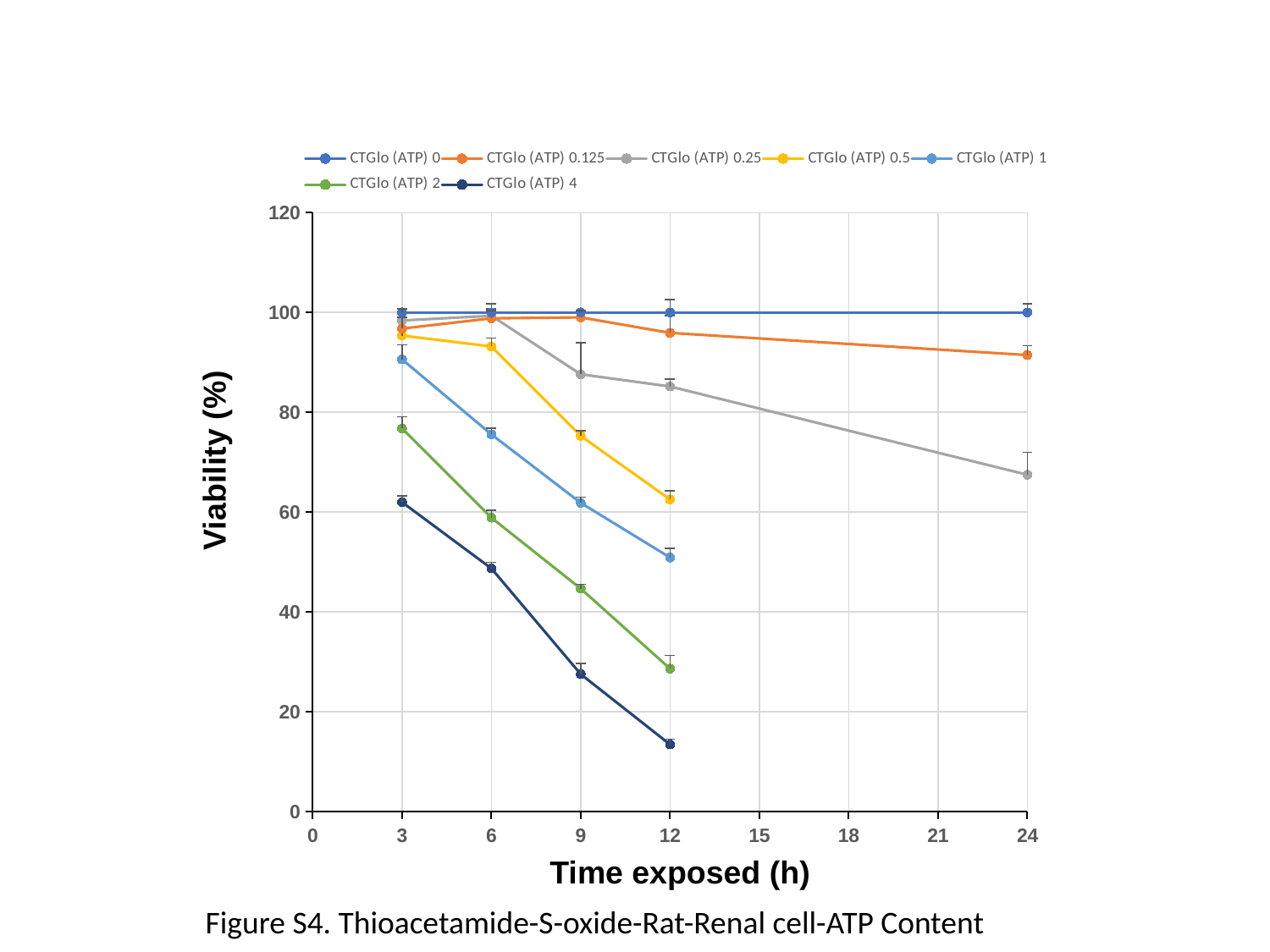
Is the value for CTGlo (ATP) 4 at 12 h greater or less than 20? less What is the title of the x axis? Time exposed (h) Which series has the highest viability at 24 h? CTGlo (ATP) 0 What kind of chart is shown on the slide? line chart Which series has the lowest viability at 12 h? CTGlo (ATP) 4 Is the value for CTGlo (ATP) 1 at 12 h greater or less than 60? less Is the value for CTGlo (ATP) 2 at 3 h greater or less than 80? less Which is larger at 9 h, the value for CTGlo (ATP) 0.5 or the value for CTGlo (ATP) 2? CTGlo (ATP) 0.5 What is the title of the y axis? Viability (%) Do the values for CTGlo (ATP) 4 rise or fall as time exposed increases? fall How many series does the legend list? 7